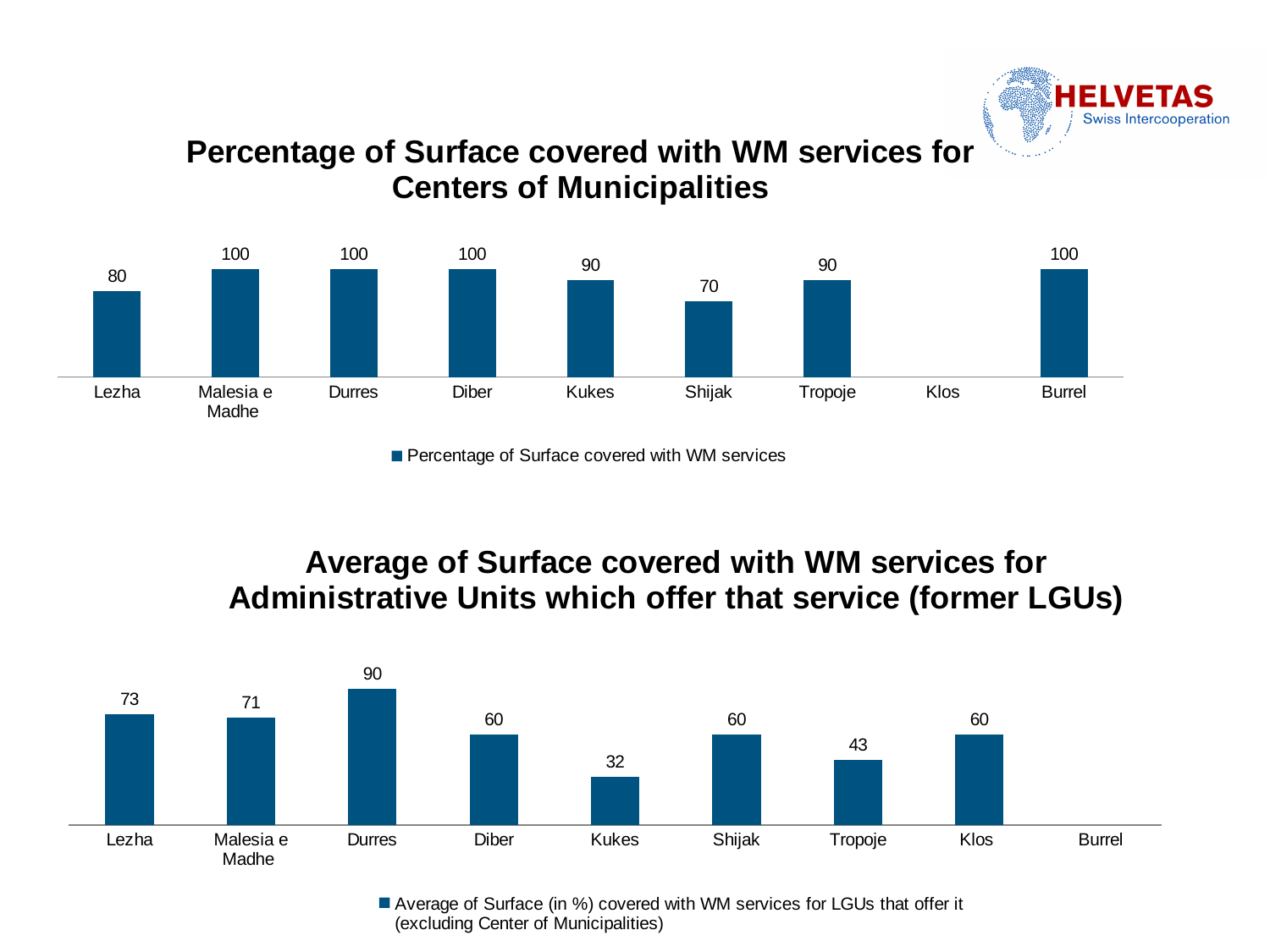
In the top chart (Centers of Municipalities), what is the difference between the values for Durres and Kukes? 10 In the bottom chart (Administrative Units), what is the difference between the values for Durres and Kukes? 58 In the top chart (Centers of Municipalities), how many categories are shown on the x axis? 9 In the bottom chart (Administrative Units), which is larger, the value for Lezha or the value for Malesia e Madhe? Lezha In the top chart (Centers of Municipalities), which municipality has the lowest plotted value? Shijak In the bottom chart (Administrative Units), what is the value for Tropoje? 43 In the bottom chart (Administrative Units), which category has the lowest value? Kukes What type of chart is the top chart (Centers of Municipalities)? Bar chart In the bottom chart (Administrative Units), which category has the highest value? Durres In the bottom chart (Average of Surface covered with WM services for Administrative Units), what is the value for Durres? 90 In the top chart (Percentage of Surface covered with WM services for Centers of Municipalities), what is the value for Lezha? 80 In the top chart (Centers of Municipalities), what is the value for Shijak? 70